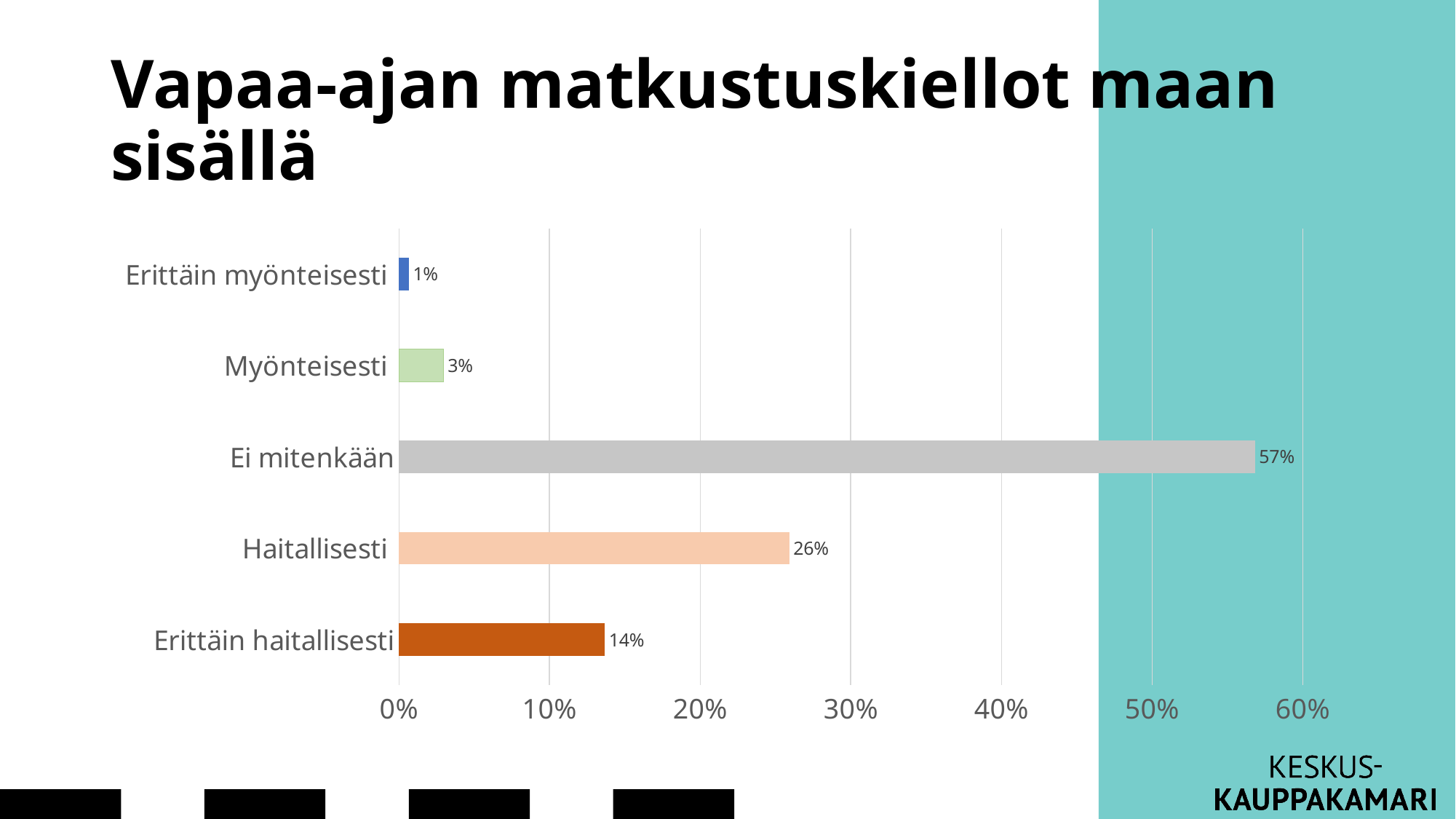
Is the value for Ei mitenkään greater or less than 50%? greater Which is larger, the value for Haitallisesti or the value for Erittäin haitallisesti? Haitallisesti What is the value for Haitallisesti? 26% What kind of chart is shown on the slide? bar chart Which category has the lowest value? Erittäin myönteisesti How many categories are shown in the chart? 5 What is the title of the slide? Vapaa-ajan matkustuskiellot maan sisällä What is the value for Ei mitenkään? 57% What is the difference between the values for Haitallisesti and Erittäin haitallisesti? 12% Which category has the highest value? Ei mitenkään What is the value for Myönteisesti? 3% What is the value for Erittäin haitallisesti? 14%